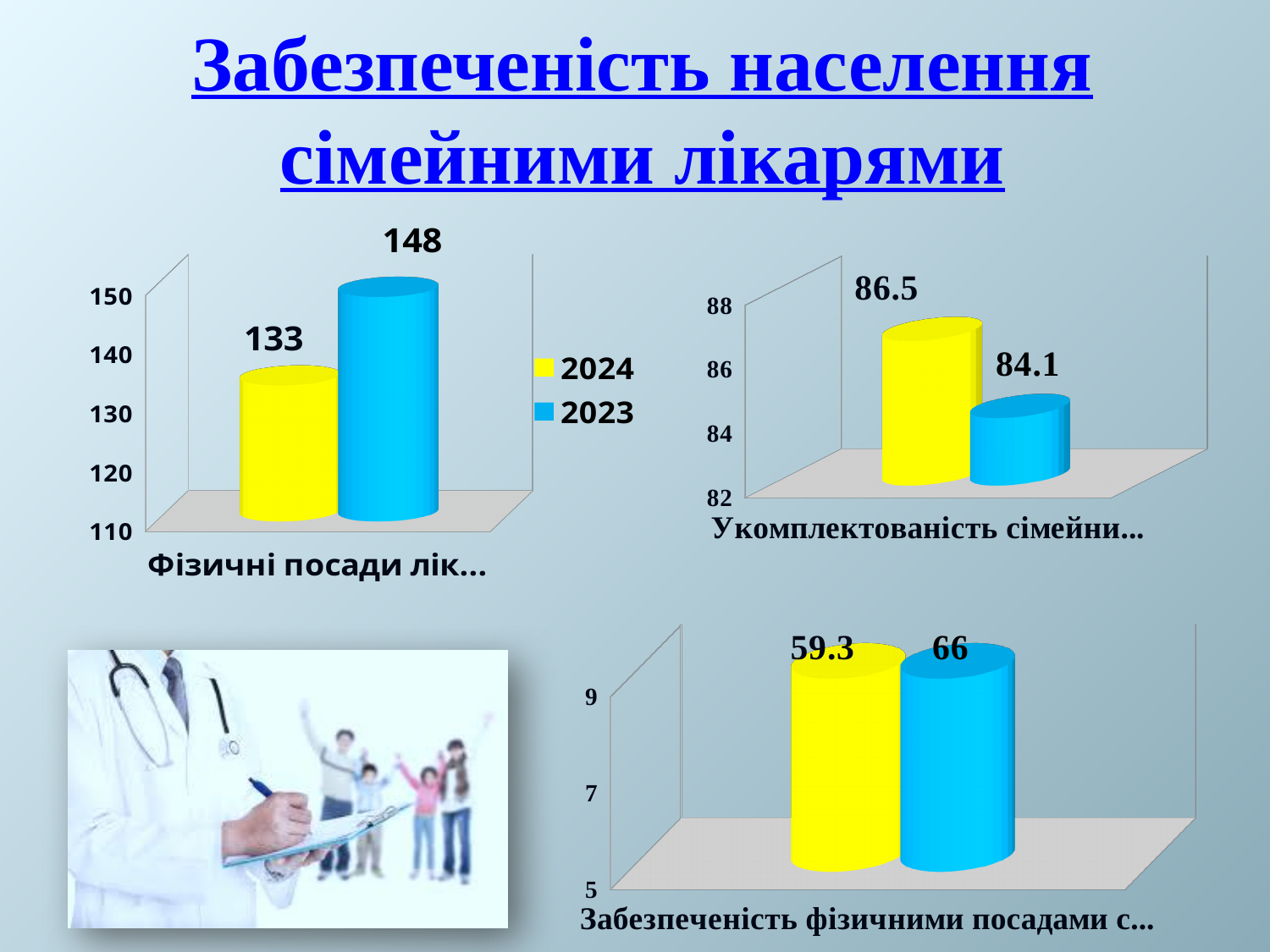
In the bottom-right chart (Забезпеченість фізичними посадами с...), what is the value shown on the blue bar? 66 In the top-right chart (Укомплектованість сімейни...), what is the value shown on the yellow bar? 86.5 In the top-left chart (Фізичні посади лік...), what is the value for 2024? 133 In the top-left chart (Фізичні посади лік...), which year has the higher value, 2023 or 2024? 2023 In the top-left chart, which colour represents 2024 in the legend? Yellow In the top-left chart (Фізичні посади лік...), what is the difference between the 2023 and 2024 values? 15 In the top-right chart (Укомплектованість сімейни...), what is the difference between the yellow bar and the blue bar values? 2.4 How many series does the legend of the top-left chart list? 2 In the bottom-right chart (Забезпеченість фізичними посадами с...), which bar has the lower value, the yellow or the blue one? Yellow In the top-right chart (Укомплектованість сімейни...), what is the value shown on the blue bar? 84.1 In the top-left chart (Фізичні посади лік...), what is the value for 2023? 148 What type of chart is the bottom-right chart (Забезпеченість фізичними посадами с...)? Bar chart